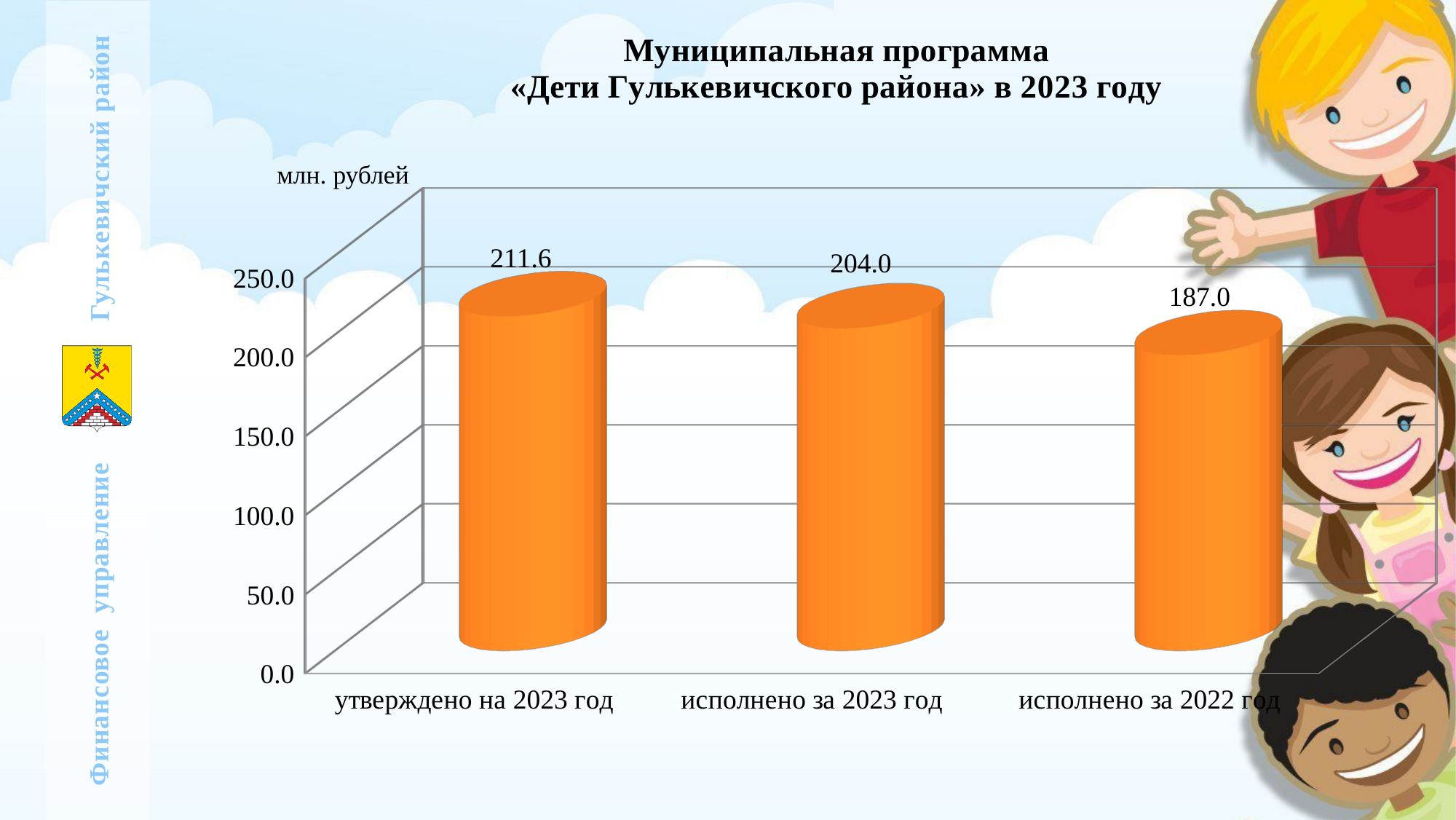
Is the value for «исполнено за 2022 год» greater or less than 200.0? less What is the difference between the values for «утверждено на 2023 год» and «исполнено за 2023 год»? 7.6 What kind of chart is shown on the slide? bar chart How many categories are shown on the chart? 3 What is the value for «утверждено на 2023 год»? 211.6 Which category has the highest value? утверждено на 2023 год What is the difference between the values for «исполнено за 2023 год» and «исполнено за 2022 год»? 17.0 What is the value for «исполнено за 2023 год»? 204.0 Which category has the lowest value? исполнено за 2022 год What is the value for «исполнено за 2022 год»? 187.0 Which is larger: the value for «исполнено за 2023 год» or «исполнено за 2022 год»? исполнено за 2023 год What unit is indicated on the chart's value axis? млн. рублей